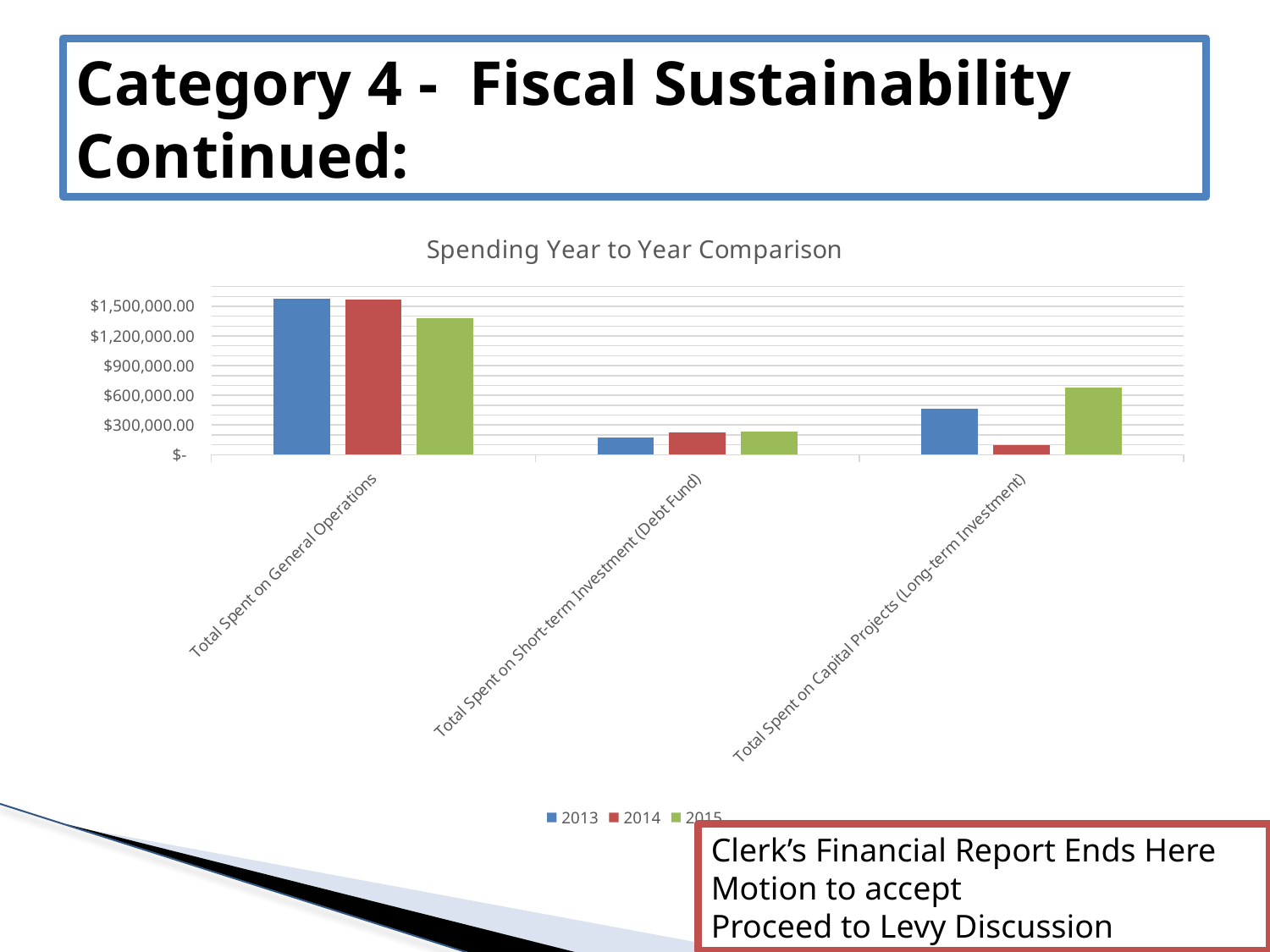
What is the title of the chart? Spending Year to Year Comparison For Total Spent on Capital Projects (Long-term Investment), which year has the lowest value? 2014 How many spending categories are shown on the x axis? 3 For Total Spent on General Operations, which is larger, the 2013 value or the 2015 value? 2013 Is the 2015 value for Total Spent on Capital Projects (Long-term Investment) greater or less than $600,000.00? greater Is the 2015 value for Total Spent on General Operations greater or less than $1,500,000.00? less Which spending category has the highest bars overall? Total Spent on General Operations How many series does the legend list? 3 For Total Spent on Capital Projects (Long-term Investment), which year has the highest value? 2015 What kind of chart is shown on the slide? bar chart Is the 2013 value for Total Spent on Short-term Investment (Debt Fund) greater or less than $300,000.00? less Which years are listed in the legend? 2013, 2014, 2015